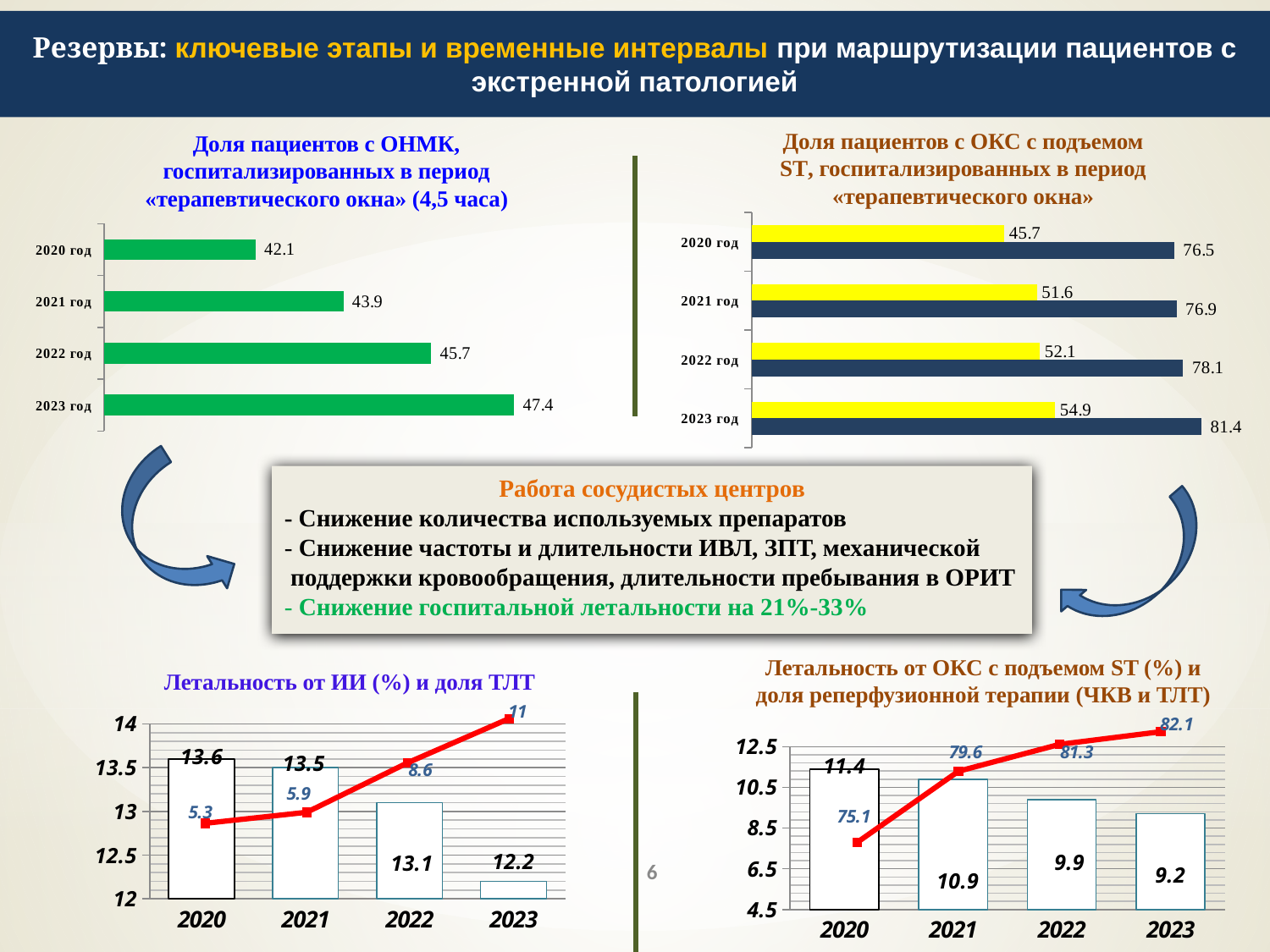
In the chart «Летальность от ИИ (%) и доля ТЛТ», what is the value of the red line for 2023? 11 In the chart «Летальность от ОКС с подъемом ST (%) и доля реперфузионной терапии (ЧКВ и ТЛТ)», which is larger: the red line value for 2020 or for 2023? 2023 In the chart «Доля пациентов с ОНМК, госпитализированных в период «терапевтического окна» (4,5 часа)», which year has the lowest value? 2020 год In the chart «Доля пациентов с ОКС с подъемом ST, госпитализированных в период «терапевтического окна»», how many years are shown? 4 In the chart «Доля пациентов с ОКС с подъемом ST, госпитализированных в период «терапевтического окна»», what is the value of the dark blue bar for 2023 год? 81.4 In the chart «Доля пациентов с ОКС с подъемом ST, госпитализированных в период «терапевтического окна»», what is the value of the yellow bar for 2021 год? 51.6 In the chart «Доля пациентов с ОНМК, госпитализированных в период «терапевтического окна» (4,5 часа)», what is the value for 2023 год? 47.4 In the chart «Летальность от ОКС с подъемом ST (%) и доля реперфузионной терапии (ЧКВ и ТЛТ)», which year has the highest bar value? 2020 What type of chart is «Доля пациентов с ОКС с подъемом ST, госпитализированных в период «терапевтического окна»»? bar chart In the chart «Доля пациентов с ОНМК, госпитализированных в период «терапевтического окна» (4,5 часа)», what is the difference between the values for 2023 год and 2020 год? 5.3 In the chart «Летальность от ИИ (%) и доля ТЛТ», what is the bar value for 2022? 13.1 In the chart «Доля пациентов с ОНМК, госпитализированных в период «терапевтического окна» (4,5 часа)», do the values rise or fall from 2020 год to 2023 год? rise